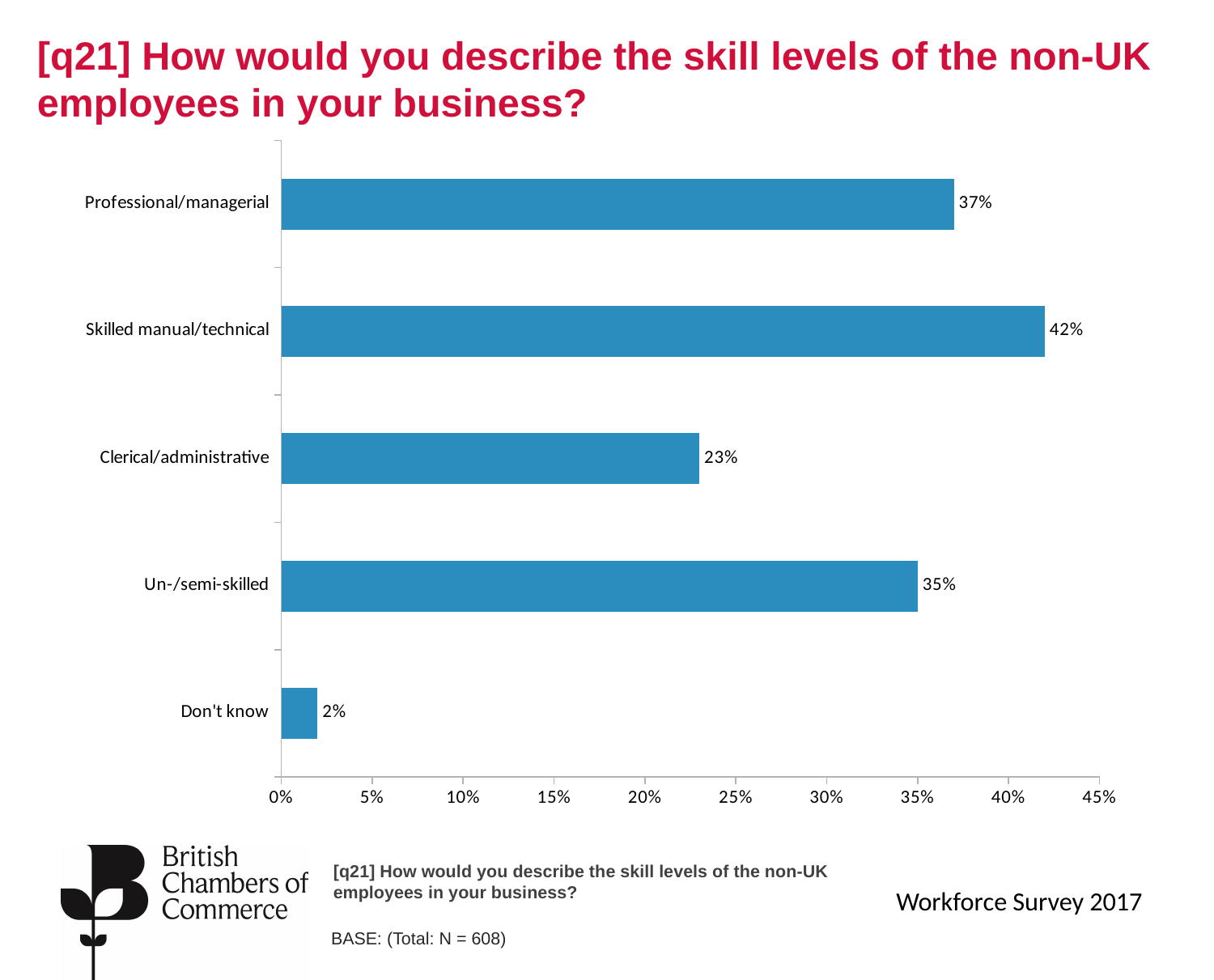
What kind of chart is shown on the slide? Bar chart What percentage of respondents described the skill level of non-UK employees as Professional/managerial? 37% What is the value shown for Clerical/administrative? 23% Which category has the lowest value? Don't know Which category has the highest value? Skilled manual/technical Is the value for Un-/semi-skilled greater or less than 30%? greater What is the base size (N) stated on the slide? 608 Which is larger, the value for Professional/managerial or the value for Un-/semi-skilled? Professional/managerial What percentage is shown for Don't know? 2% What is the value shown for Skilled manual/technical? 42% What is the difference between the values for Skilled manual/technical and Clerical/administrative? 19% How many categories are shown in the chart? 5